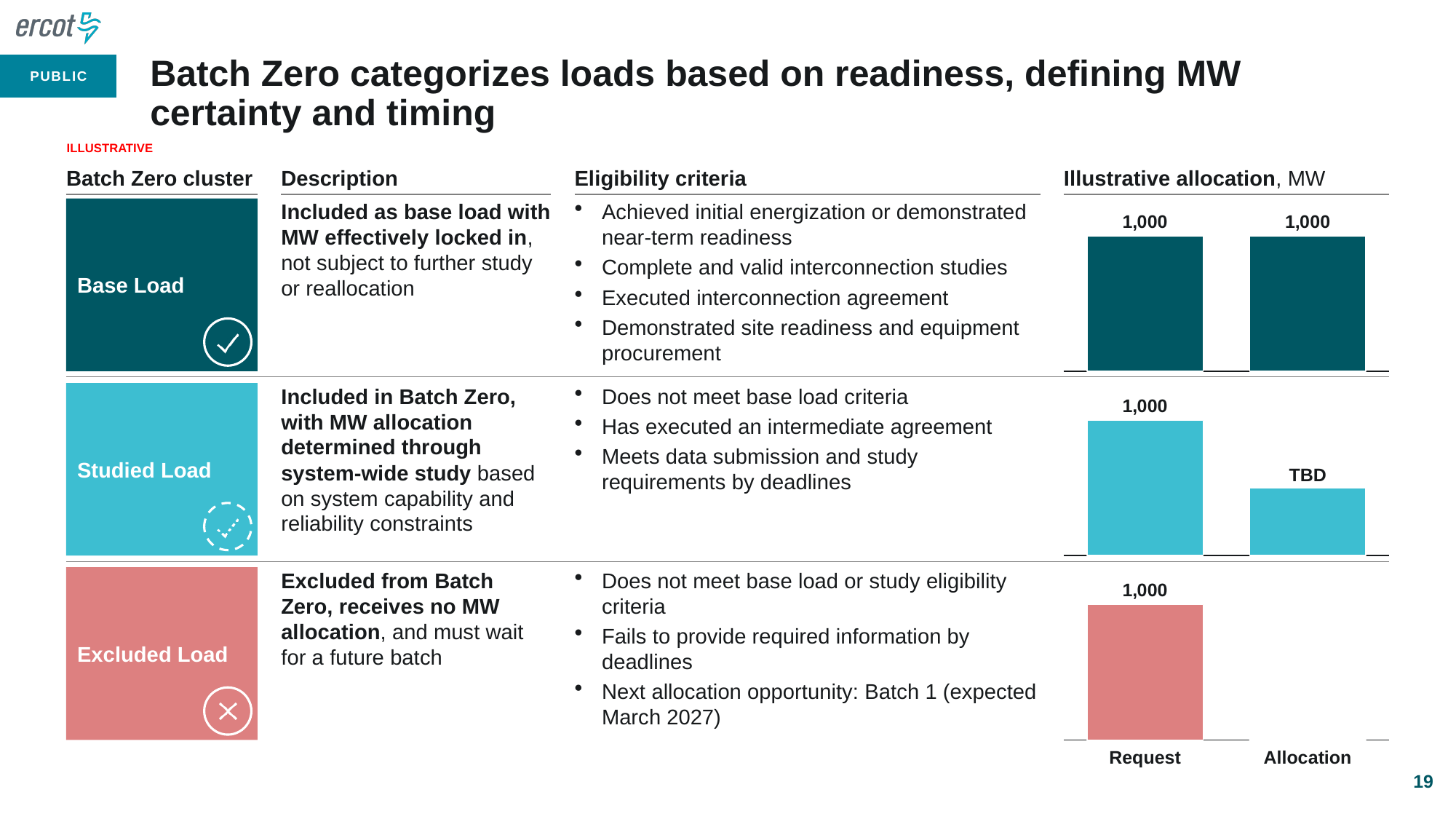
In the Studied Load row of the Illustrative allocation chart, which bar is taller, Request or Allocation? Request What are the two category labels at the bottom of the Illustrative allocation charts? Request and Allocation In the Excluded Load row of the Illustrative allocation chart, what is the Request value? 1,000 How many bars are shown in the Base Load row of the Illustrative allocation chart? 2 In the Excluded Load row of the Illustrative allocation chart, is there an Allocation bar shown? No In the Base Load row of the Illustrative allocation chart, what is the difference between the Request and Allocation values? 0 What unit is stated in the header of the Illustrative allocation column? MW What kind of chart is used in the Illustrative allocation column? Bar chart In the Base Load row of the Illustrative allocation chart, what is the Request value? 1,000 In the Studied Load row of the Illustrative allocation chart, what is the Request value? 1,000 In the Studied Load row of the Illustrative allocation chart, what label is shown above the Allocation bar? TBD In the Base Load row of the Illustrative allocation chart, what is the Allocation value? 1,000